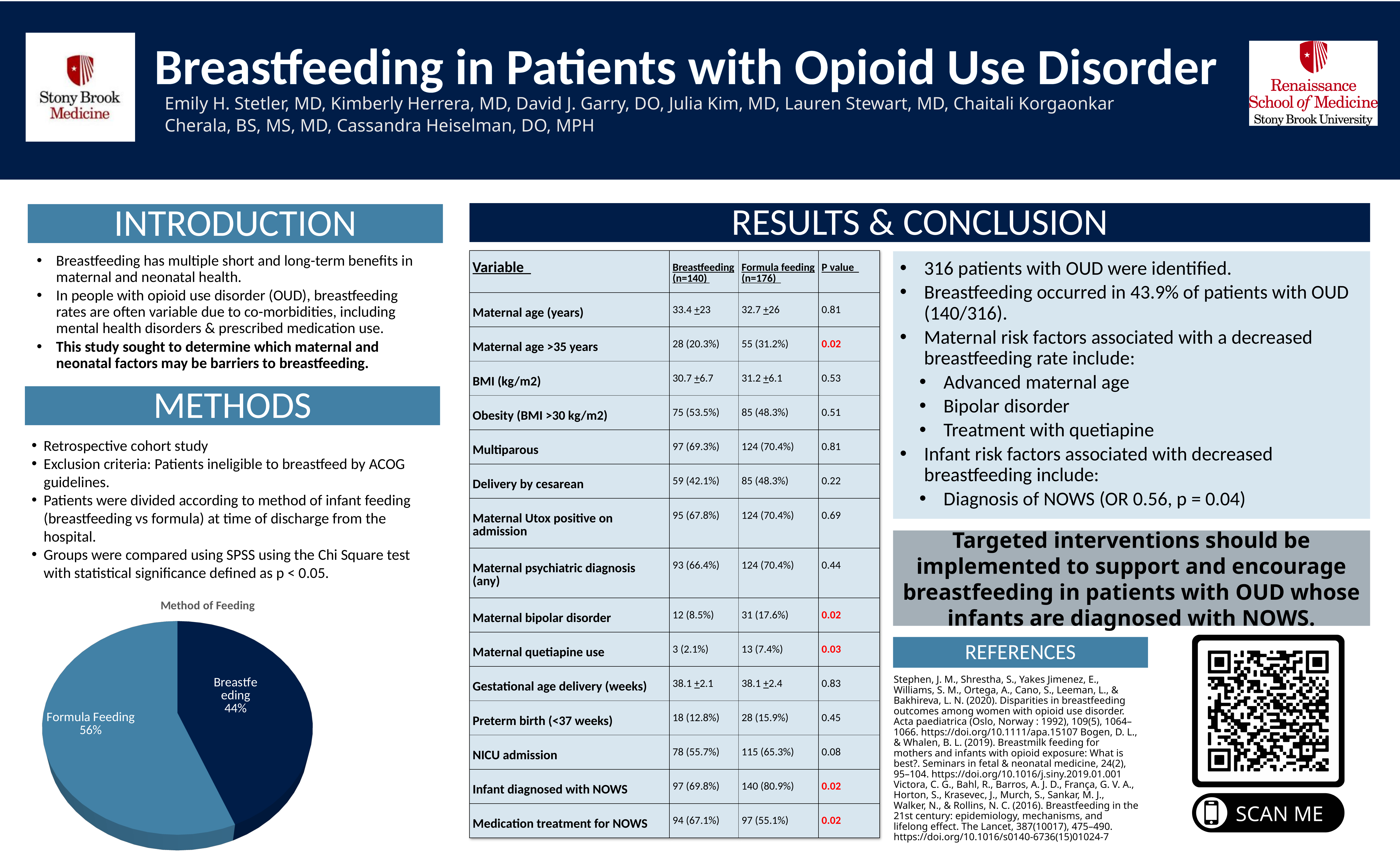
In the "Method of Feeding" pie chart, what is the difference in percentage points between Formula Feeding and Breastfeeding? 12 How many slices does the "Method of Feeding" pie chart have? 2 What is the title of the pie chart? Method of Feeding In the "Method of Feeding" pie chart, what colour is the Breastfeeding slice? dark navy blue What kind of chart is the "Method of Feeding" chart? pie chart In the "Method of Feeding" pie chart, which is larger, Formula Feeding or Breastfeeding? Formula Feeding Which slice of the "Method of Feeding" pie chart is the largest? Formula Feeding What share of the "Method of Feeding" pie is Breastfeeding? 44% Which slice of the "Method of Feeding" pie chart is the smallest? Breastfeeding What share of the "Method of Feeding" pie is Formula Feeding? 56% In the "Method of Feeding" pie chart, is the Breastfeeding share greater or less than 50%? less